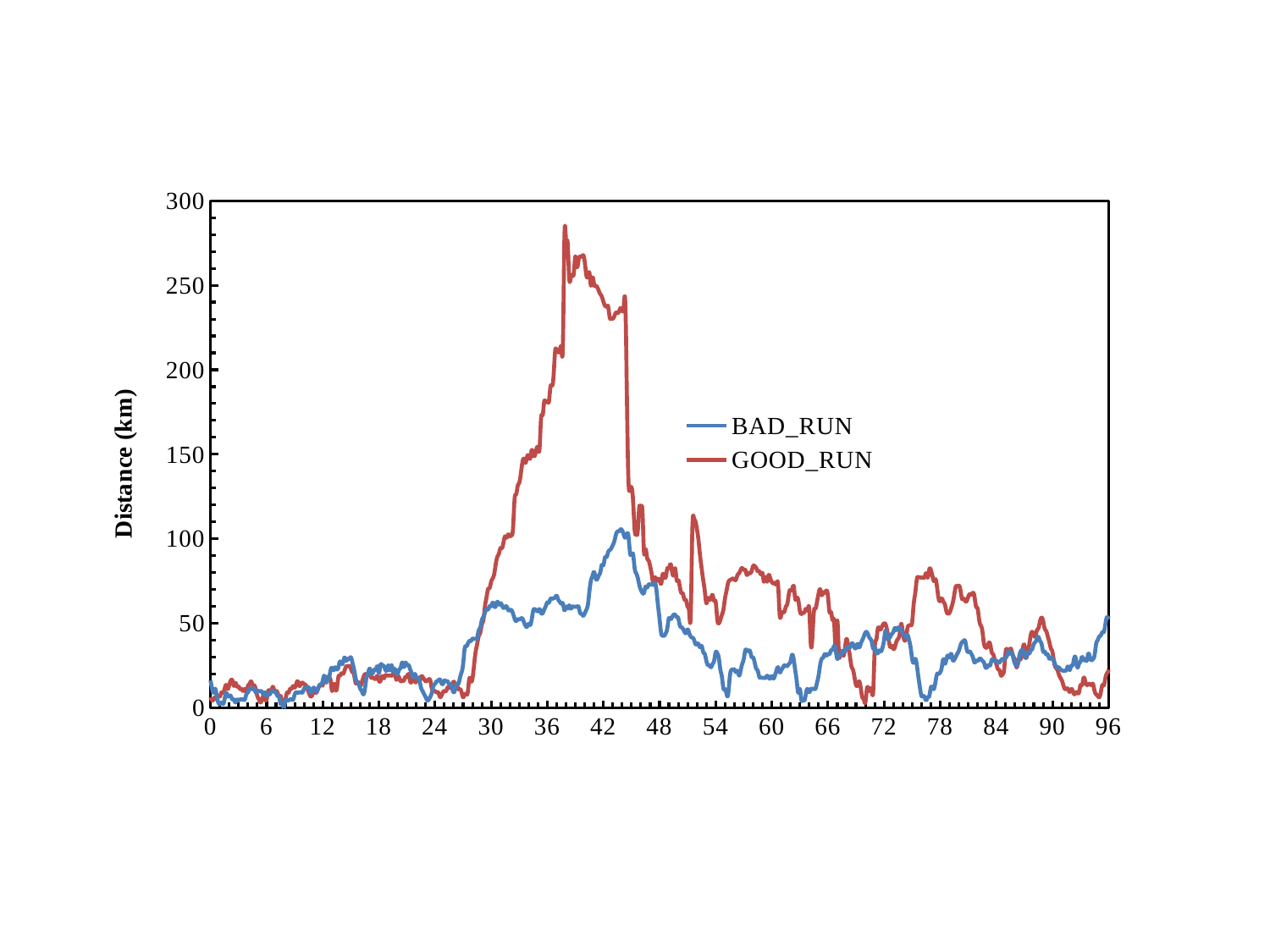
Is the value for BAD_RUN at x = 60 greater or less than 50? less Is the value for GOOD_RUN at x = 38 greater or less than 250? greater Is the value for GOOD_RUN at x = 60 greater or less than 50? greater What is the label of the y axis? Distance (km) At x = 60, which series has the larger value, BAD_RUN or GOOD_RUN? GOOD_RUN At x = 36, which series has the larger value, BAD_RUN or GOOD_RUN? GOOD_RUN How many series does the legend list? 2 Which series reaches the highest value on the chart? GOOD_RUN What kind of chart is shown on the slide? line chart Which colour is used for the GOOD_RUN series? red